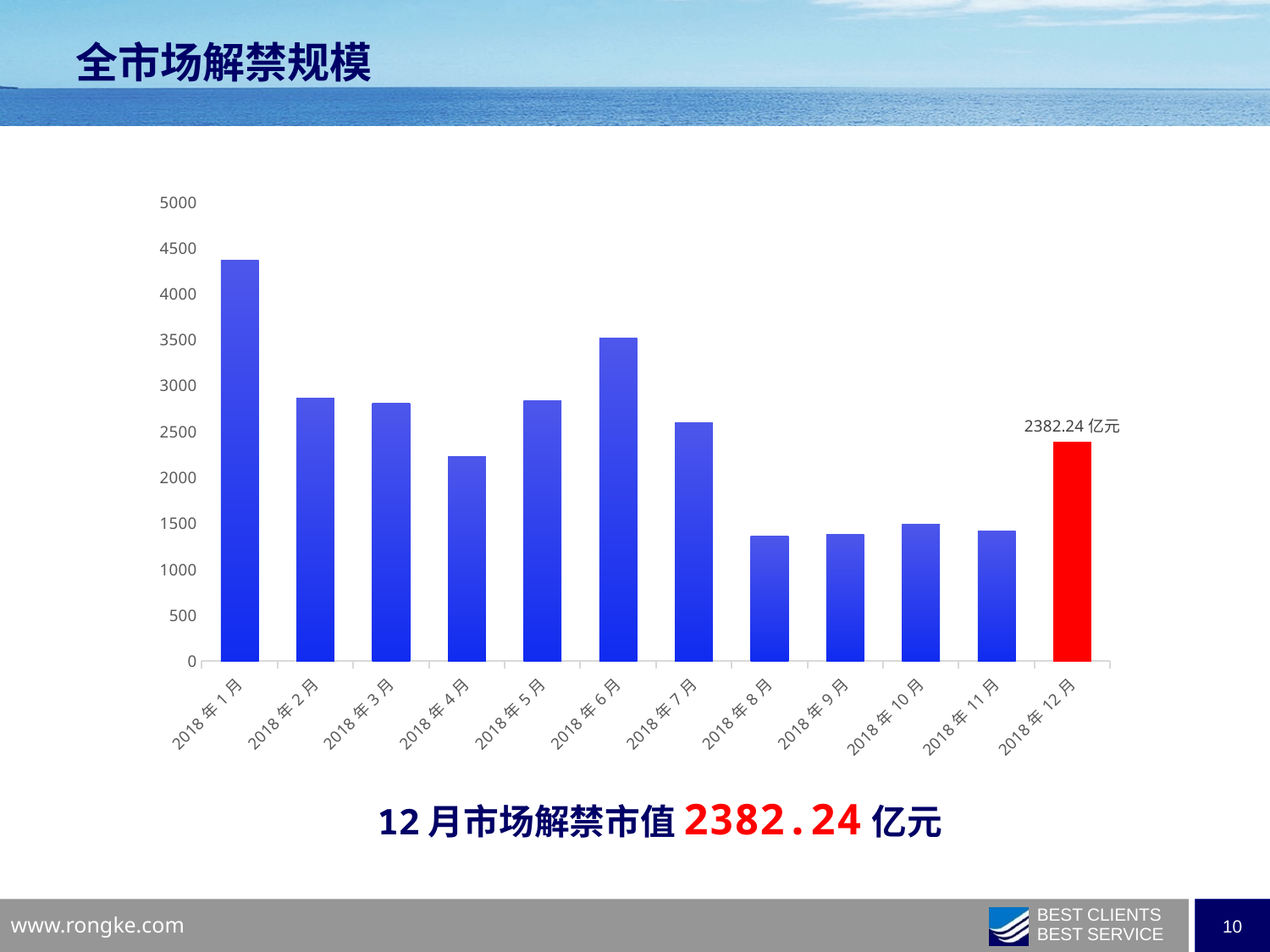
Which month's bar is coloured red? 2018年12月 Is the value for 2018年6月 greater or less than 3000? greater What kind of chart is shown on the slide? bar chart Is the value for 2018年1月 greater or less than 4000? greater What is the value shown for 2018年12月? 2382.24 亿元 Which is larger, the value for 2018年1月 or 2018年6月? 2018年1月 Which is larger, the value for 2018年4月 or 2018年5月? 2018年5月 Do the values rise or fall from 2018年6月 to 2018年8月? fall Which month has the highest bar? 2018年1月 Is the value for 2018年4月 greater or less than 2000? greater How many months are shown on the x axis? 12